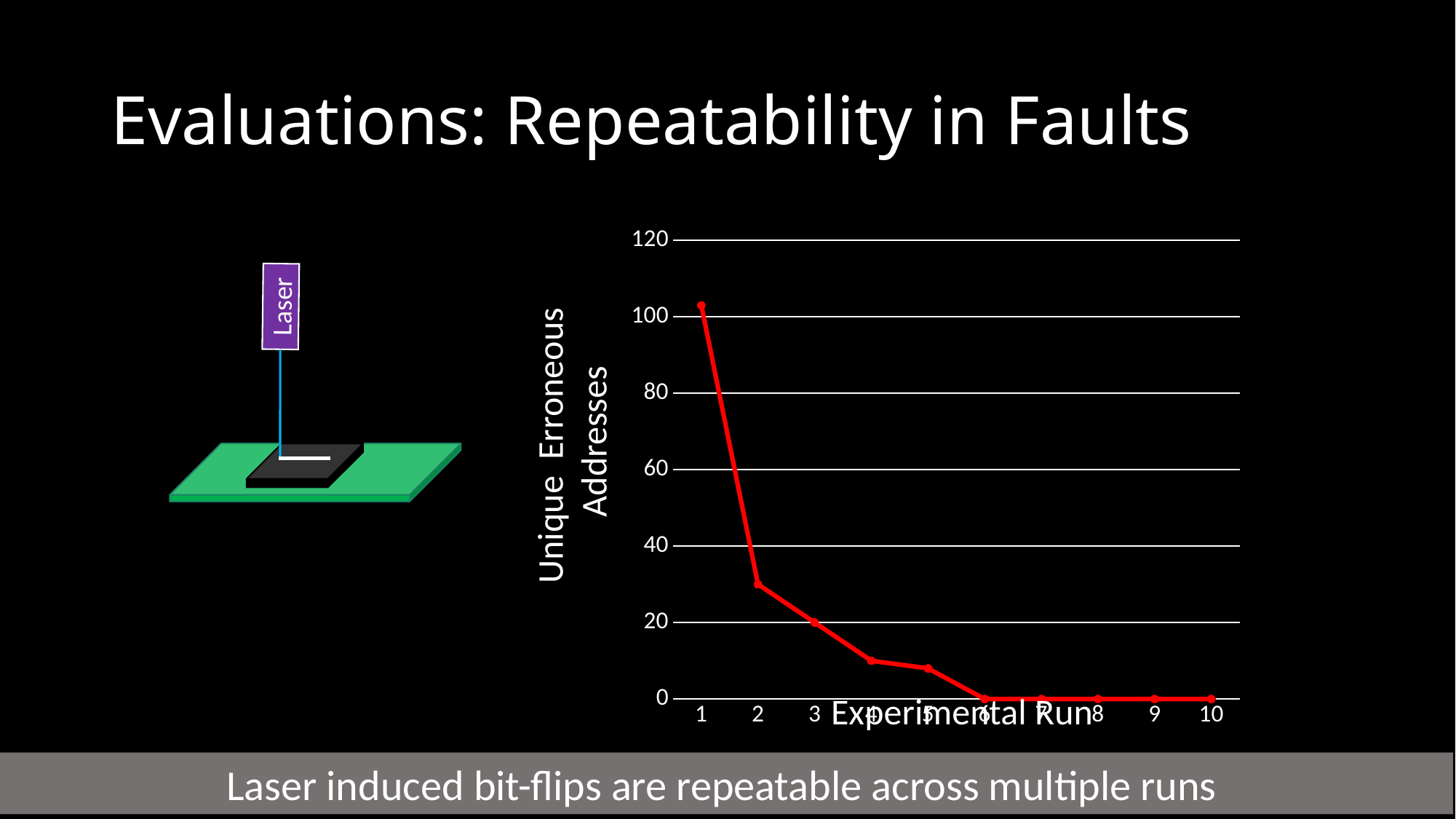
Do the values rise or fall as the experimental run number increases? fall What is the title of the y axis? Unique Erroneous Addresses Is the value for experimental run 1 greater or less than 80? greater Which has more unique erroneous addresses, experimental run 1 or experimental run 2? experimental run 1 Is the value for experimental run 2 greater or less than 40? less Is the value for experimental run 4 greater or less than 20? less Which experimental run has the highest number of unique erroneous addresses? 1 How many experimental runs have a value of 0 unique erroneous addresses? 5 What kind of chart is shown on the slide? line chart What is the number of unique erroneous addresses for experimental run 7? 0 What is the number of unique erroneous addresses for experimental run 10? 0 How many experimental runs are plotted on the x axis? 10